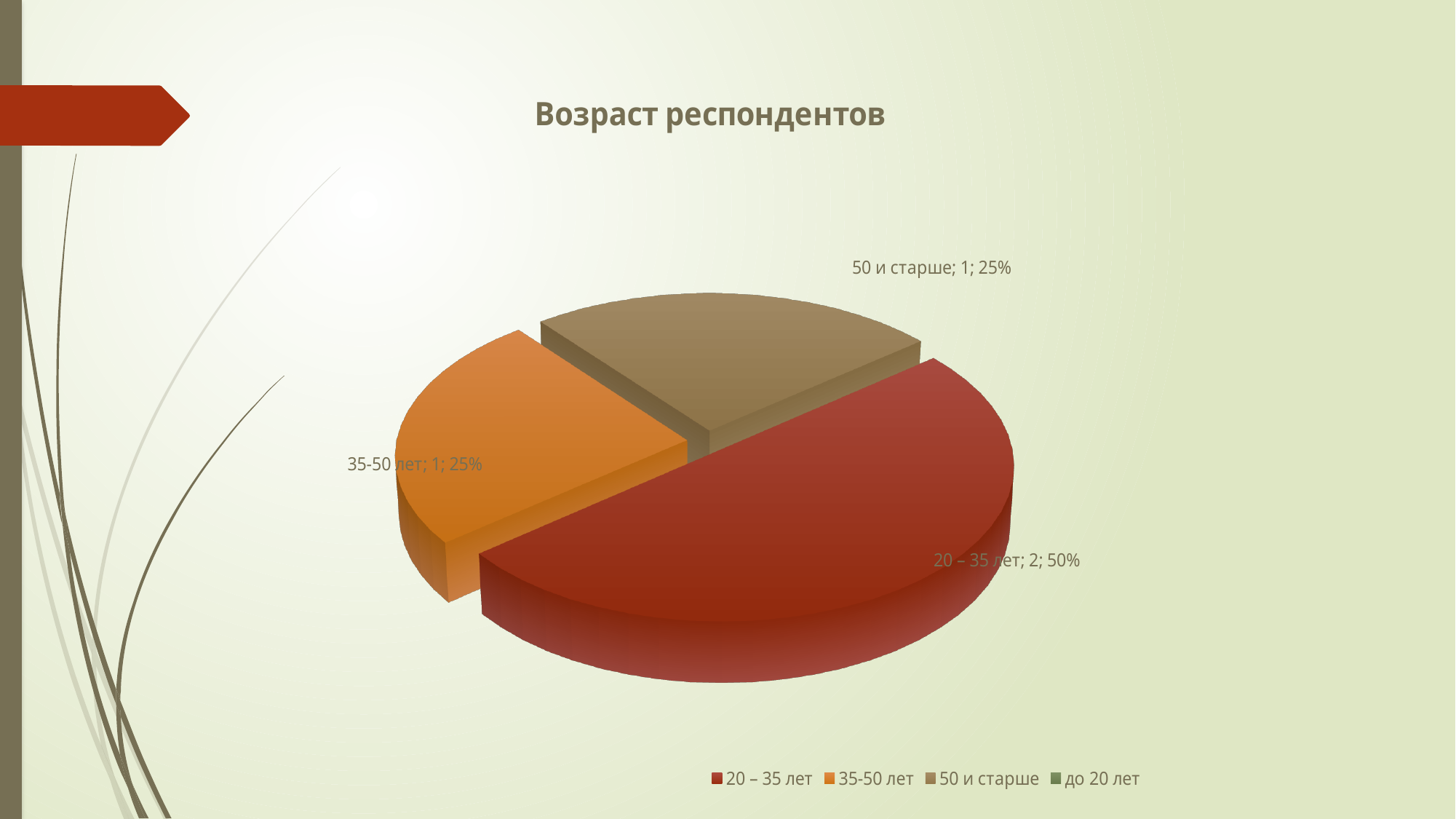
How many entries does the legend list? 4 Which category has the largest slice of the pie? 20 – 35 лет What is the count value shown for "20 – 35 лет"? 2 What is the difference in percentage points between the "20 – 35 лет" slice and the "35-50 лет" slice? 25% What percentage share does the "50 и старше" slice have? 25% What kind of chart is shown on the slide? pie chart What percentage share does the "35-50 лет" slice have? 25% What is the title of the chart? Возраст респондентов Which is larger, the share for "20 – 35 лет" or the share for "50 и старше"? 20 – 35 лет Which legend entry has no visible slice in the pie? до 20 лет What percentage share does the "20 – 35 лет" slice have? 50% What is the count value shown for "50 и старше"? 1